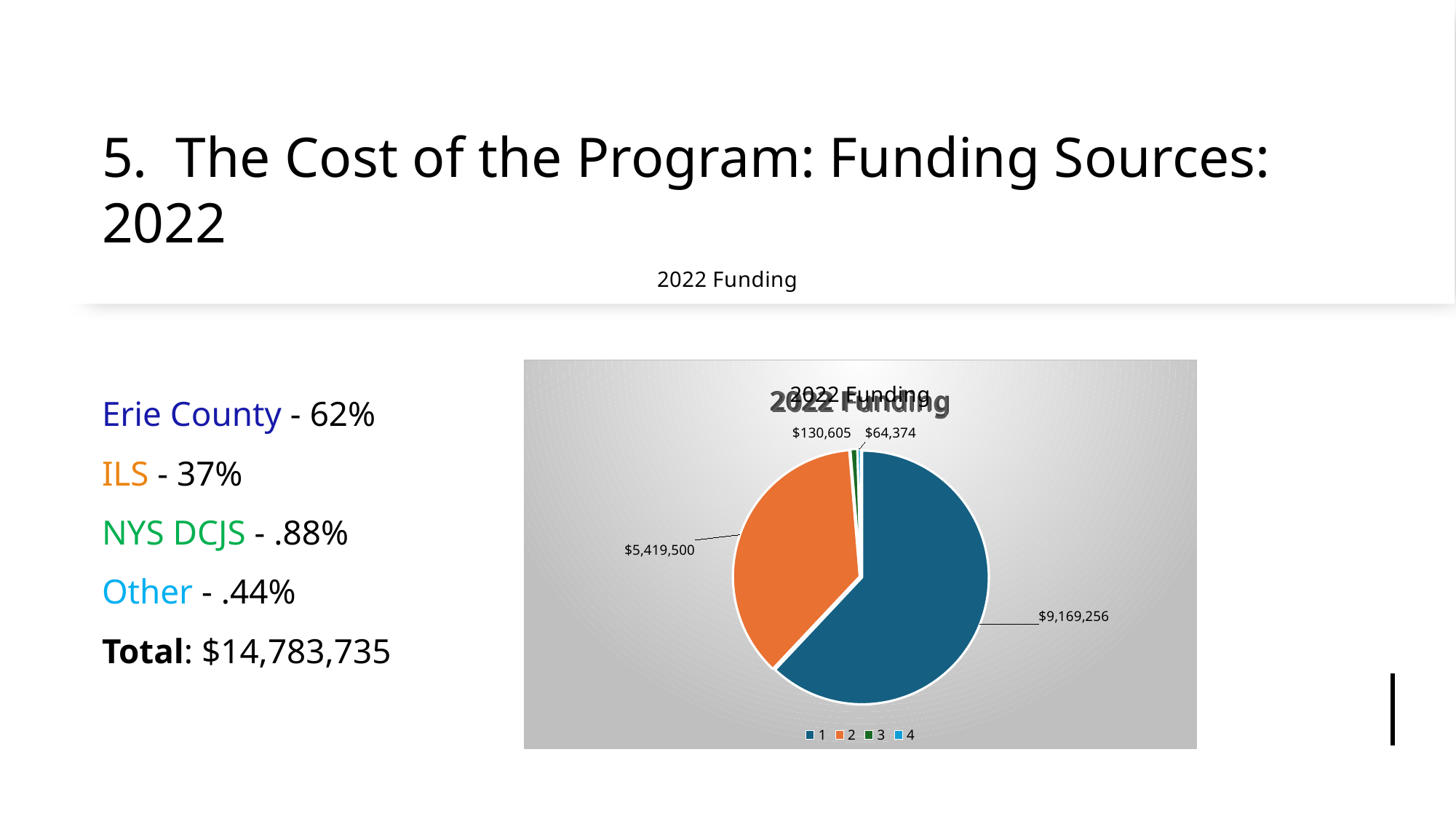
What is the title of the chart? 2022 Funding What is the value of the smallest slice of the pie chart? $64,374 According to the slide, what share of 2022 funding does the largest slice (Erie County) represent? 62% How many slices does the pie chart have? 4 What value is labelled on the green slice (legend entry 3)? $130,605 What is the difference between the blue slice ($9,169,256) and the orange slice ($5,419,500)? $3,749,756 How many entries does the chart legend list? 4 What value is labelled on the orange slice (legend entry 2)? $5,419,500 What is the total of all four slices in the pie chart? $14,783,735 What is the value of the largest slice of the pie chart? $9,169,256 Which slice is larger, the green slice or the light blue slice? the green slice What kind of chart is shown on the slide? pie chart